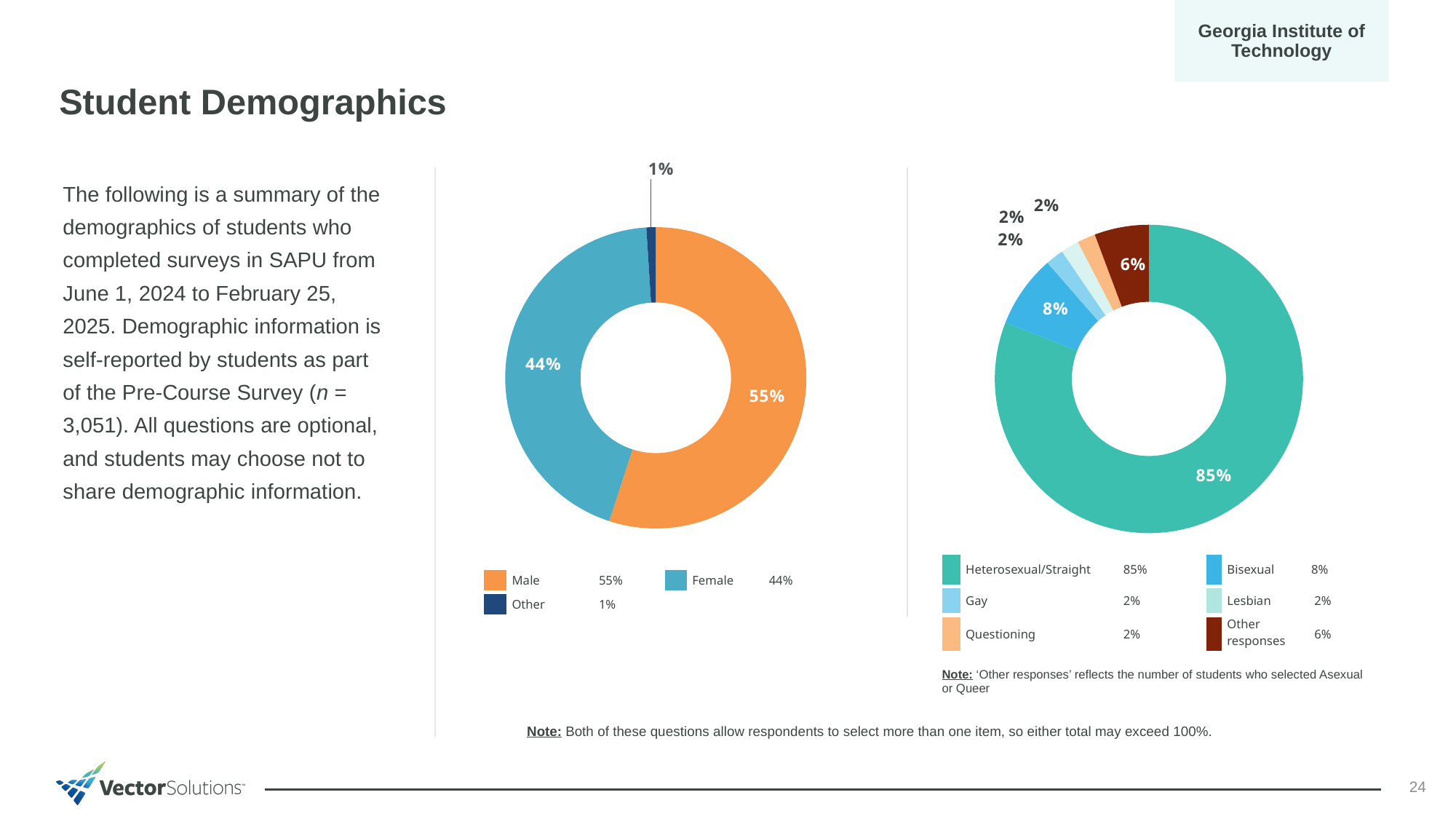
In the right donut chart (sexual orientation), what percentage is shown for Bisexual? 8% In the left donut chart (gender), how many categories does the legend list? 3 In the left donut chart (gender), what percentage is shown for Female? 44% In the left donut chart (gender), what percentage is shown for Male? 55% What type of chart is used for the two demographic charts on the slide? Donut (pie) chart In the right donut chart (sexual orientation), how many categories does the legend list? 6 In the right donut chart (sexual orientation), which category has the largest share? Heterosexual/Straight In the right donut chart (sexual orientation), which is larger, Bisexual or Other responses? Bisexual In the right donut chart (sexual orientation), what percentage is shown for Heterosexual/Straight? 85% In the left donut chart (gender), what is the difference between the Male and Female percentages? 11% In the left donut chart (gender), which category has the smallest share? Other In the right donut chart (sexual orientation), what percentage is shown for Other responses? 6%